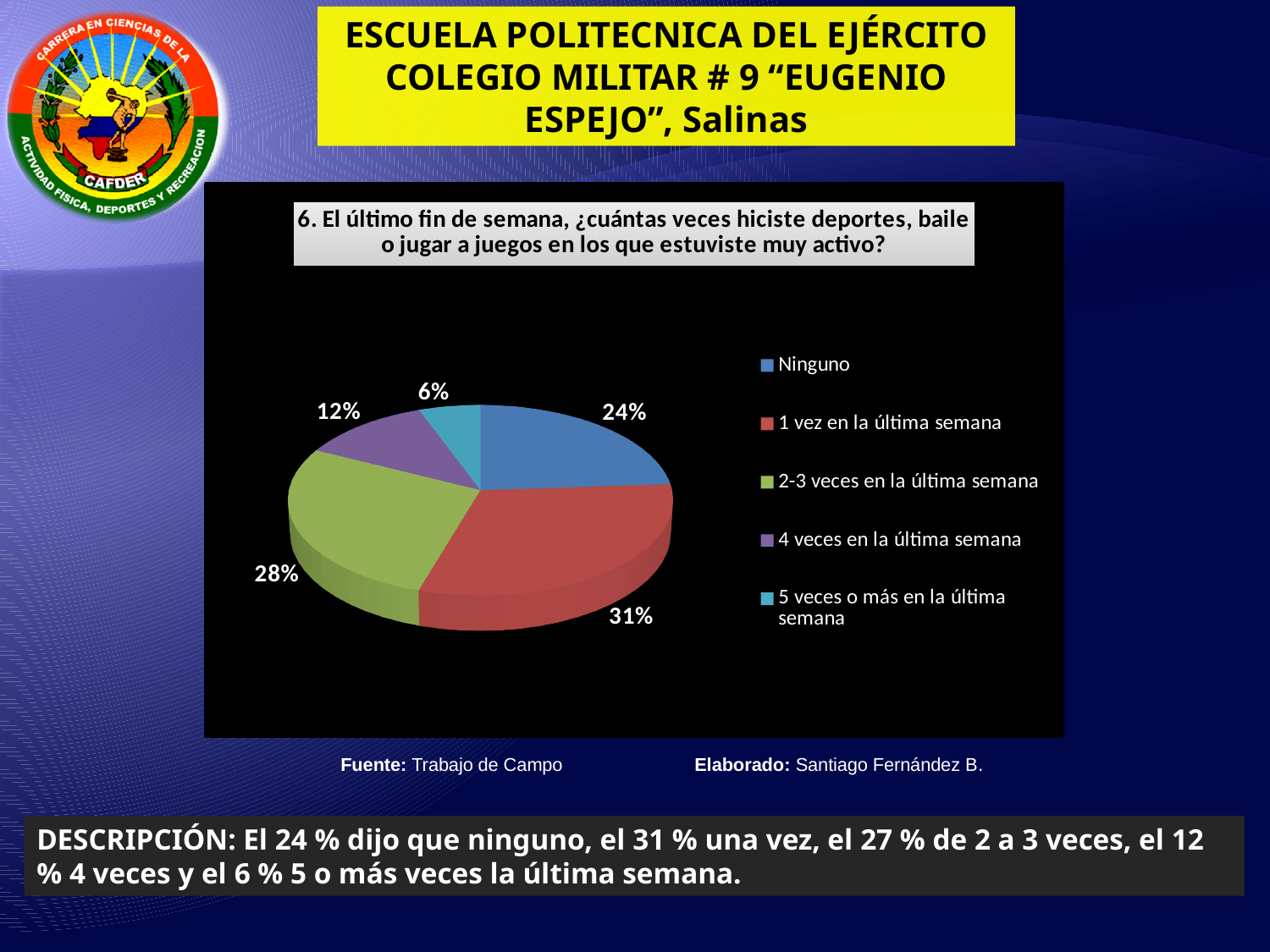
How many categories does the legend of the pie chart list? 5 Which category has the largest share of the pie? 1 vez en la última semana What percentage of the pie corresponds to "Ninguno"? 24% What percentage of the pie corresponds to "4 veces en la última semana"? 12% What kind of chart is shown on the slide? Pie chart Which category has the smallest share of the pie? 5 veces o más en la última semana What percentage of the pie corresponds to "1 vez en la última semana"? 31% What percentage of the pie corresponds to "5 veces o más en la última semana"? 6% What colour is the slice for "Ninguno" in the pie chart? Blue What percentage of the pie corresponds to "2-3 veces en la última semana"? 28% Which is larger: the share for "2-3 veces en la última semana" or the share for "4 veces en la última semana"? 2-3 veces en la última semana What is the difference in percentage points between "1 vez en la última semana" and "Ninguno"? 7